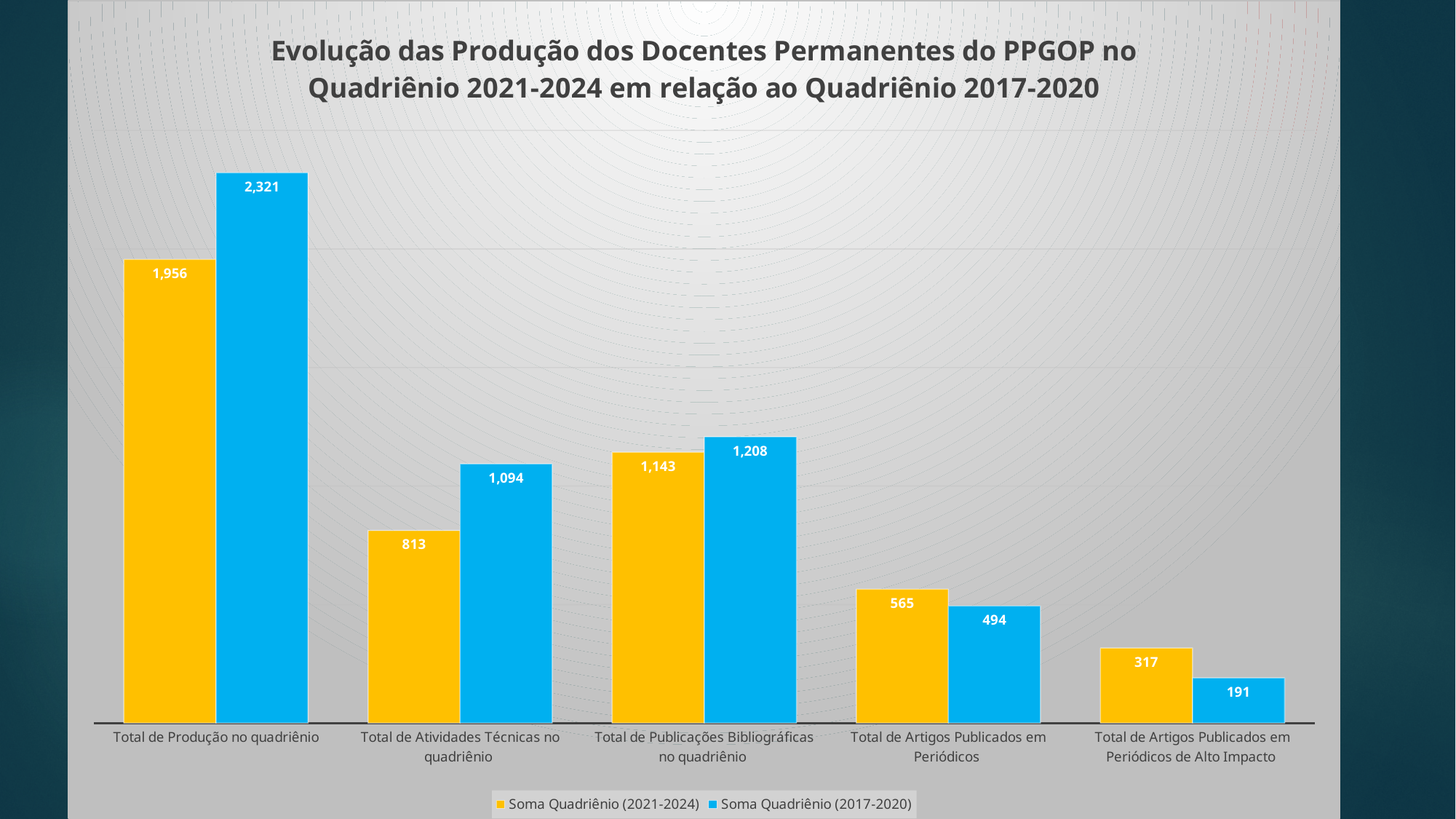
How many categories are shown on the x axis? 5 For Total de Atividades Técnicas no quadriênio, which series has the larger value: Soma Quadriênio (2021-2024) or Soma Quadriênio (2017-2020)? Soma Quadriênio (2017-2020) Which category has the highest value for Soma Quadriênio (2017-2020)? Total de Produção no quadriênio What is the difference between the Soma Quadriênio (2017-2020) and Soma Quadriênio (2021-2024) values for Total de Produção no quadriênio? 365 What is the value of Soma Quadriênio (2021-2024) for Total de Artigos Publicados em Periódicos de Alto Impacto? 317 For Total de Artigos Publicados em Periódicos, which series has the larger value: Soma Quadriênio (2021-2024) or Soma Quadriênio (2017-2020)? Soma Quadriênio (2021-2024) What is the value of Soma Quadriênio (2017-2020) for Total de Atividades Técnicas no quadriênio? 1,094 How many series does the legend list? 2 What is the difference between the Soma Quadriênio (2021-2024) and Soma Quadriênio (2017-2020) values for Total de Artigos Publicados em Periódicos de Alto Impacto? 126 What is the value of Soma Quadriênio (2021-2024) for Total de Produção no quadriênio? 1,956 Which category has the lowest value for Soma Quadriênio (2021-2024)? Total de Artigos Publicados em Periódicos de Alto Impacto What kind of chart is shown on the slide? Bar chart